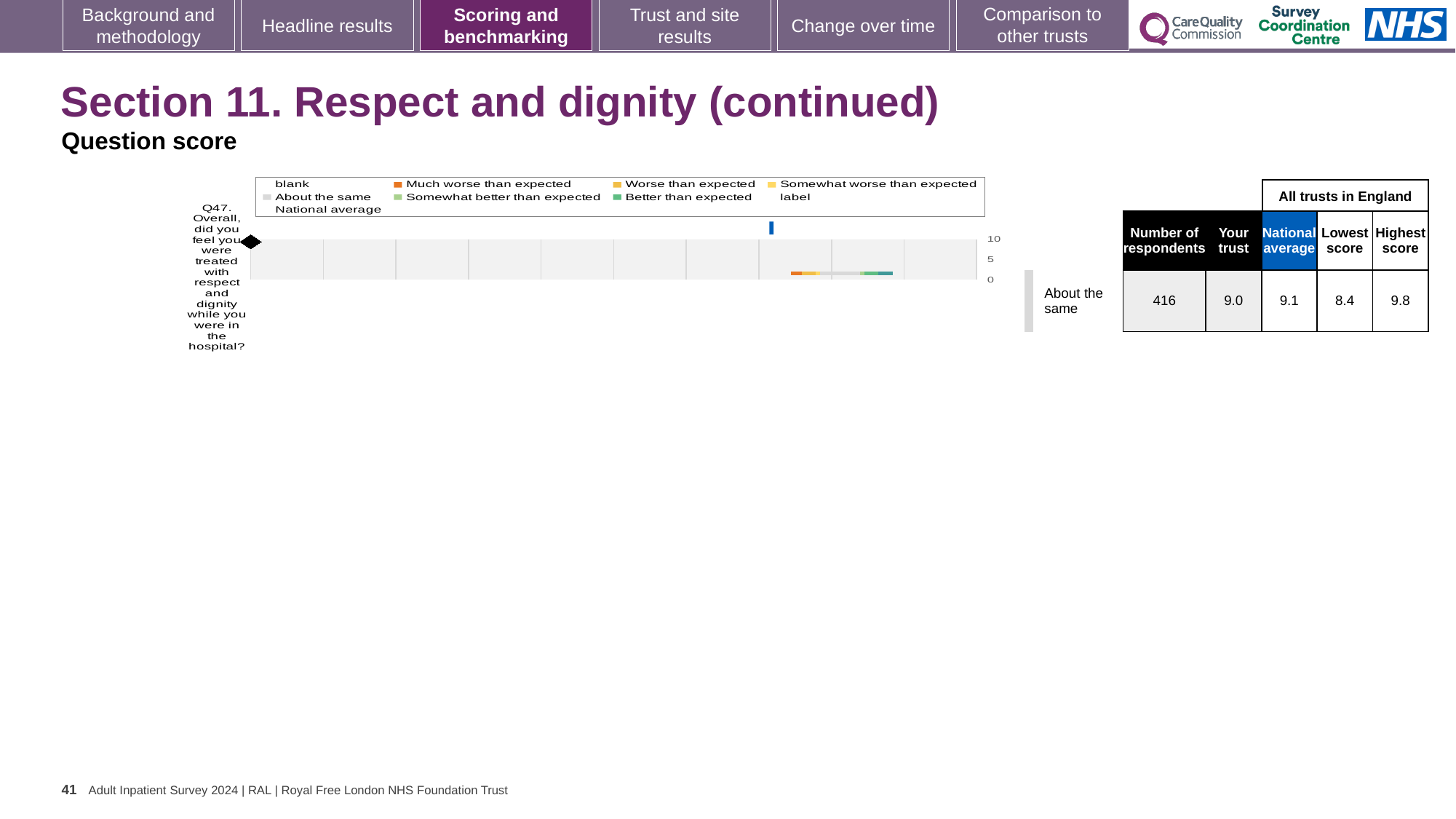
In the table beside the chart, what is the lowest score among all trusts in England for Q47? 8.4 Which benchmark category is Q47 placed in, according to the label next to the chart? About the same What is the highest value shown on the chart's score axis? 10 What kind of chart is shown on the slide? bar chart What is the difference between the highest score and the lowest score for Q47 in the table beside the chart? 1.4 Which question is plotted on the chart? Q47. Overall, did you feel you were treated with respect and dignity while you were in the hospital? In the table beside the chart, what is the national average score for Q47? 9.1 Which is larger for Q47: the 'Your trust' score or the national average? National average In the table beside the chart, what is the highest score among all trusts in England for Q47? 9.8 In the table beside the chart, how many respondents answered Q47? 416 How many questions (categories) are plotted on the chart? 1 In the table beside the chart, what is the 'Your trust' score for Q47? 9.0